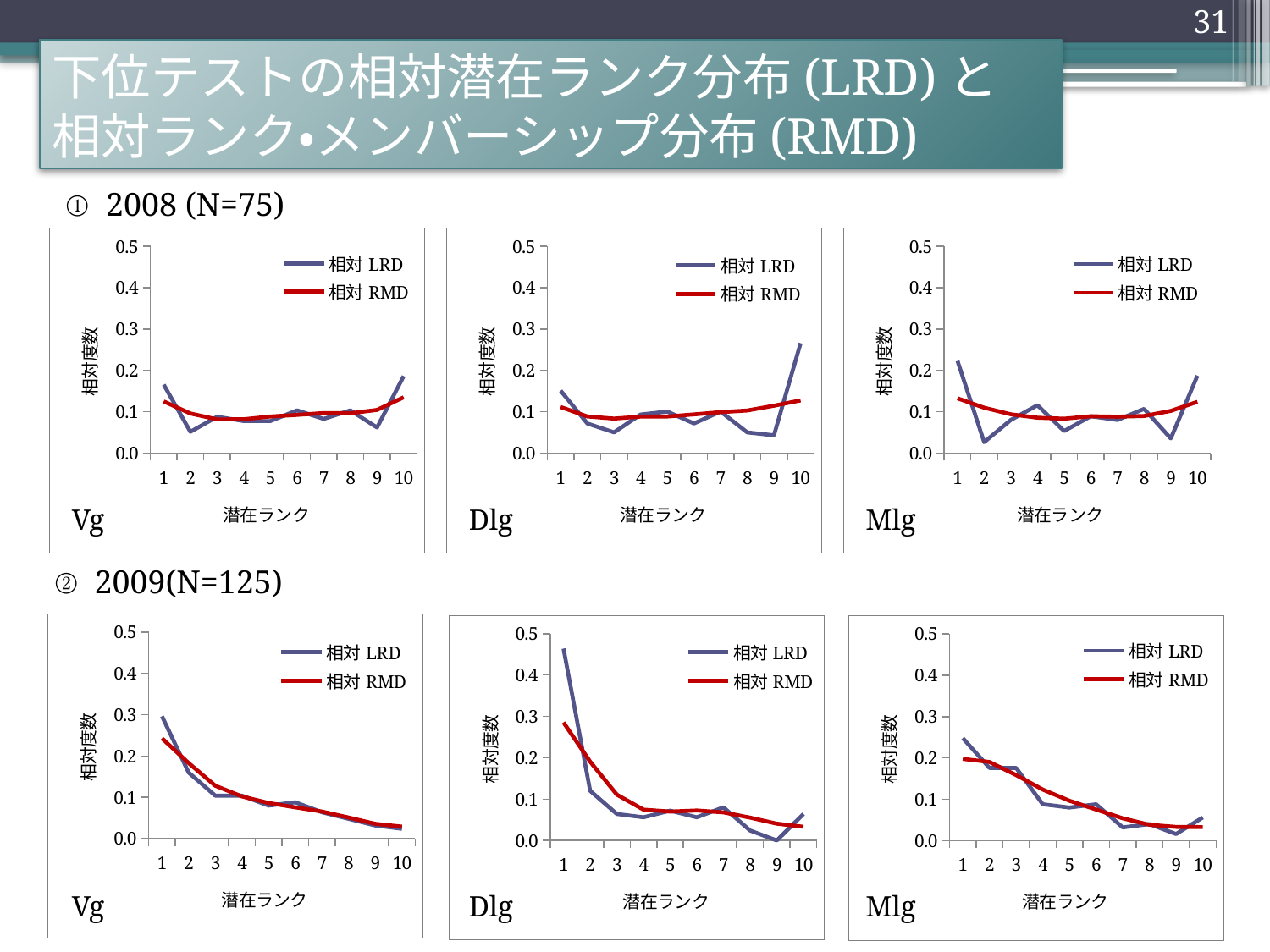
In the 2008 Dlg chart, at which 潜在ランク is the 相対 LRD series highest? 10 In the 2008 Mlg chart, is the 相対 LRD value at 潜在ランク 2 greater or less than 0.1? less In the 2008 Mlg chart, at which 潜在ランク is the 相対 LRD series lowest? 2 How many series does the legend of the 2009 Dlg chart list? 2 How many 潜在ランク points are plotted along the x axis of the 2008 Mlg chart? 10 What kind of chart is the 2008 Vg chart? line chart In the 2008 Dlg chart, is the 相対 LRD value at 潜在ランク 10 greater or less than 0.2? greater In the 2009 Vg chart, does the 相対 RMD series generally rise or fall as 潜在ランク increases from 1 to 10? fall What is the y-axis label of the 2008 Vg chart? 相対度数 In the 2009 Dlg chart, at which 潜在ランク is the 相対 LRD series highest? 1 In the 2009 Mlg chart, which series is larger at 潜在ランク 1, 相対 LRD or 相対 RMD? 相対 LRD In the 2009 Dlg chart, is the 相対 LRD value at 潜在ランク 1 greater or less than 0.4? greater